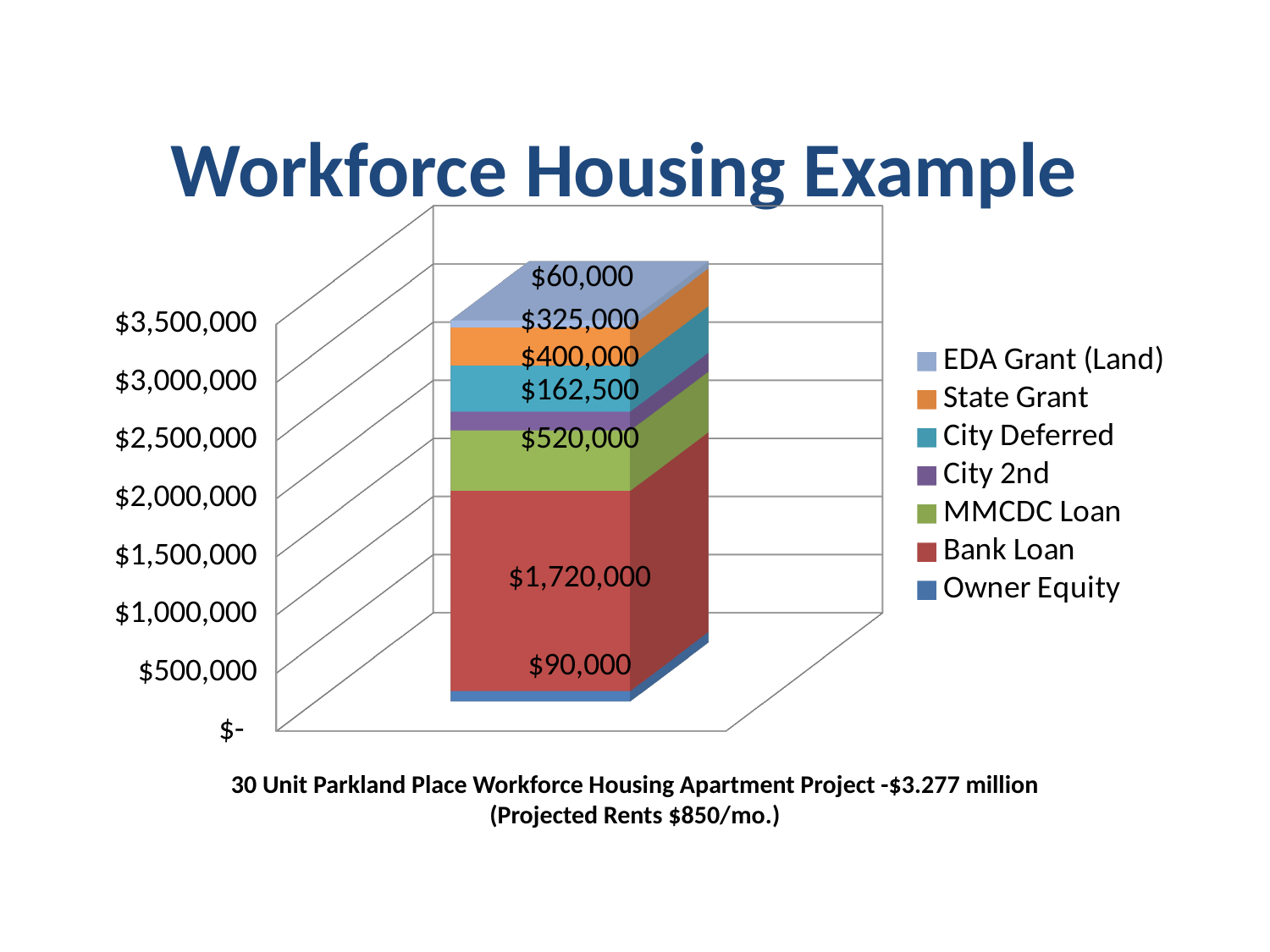
What is the difference between the City Deferred and State Grant amounts? $75,000 What is the value of the MMCDC Loan segment? $520,000 What is the value of the City 2nd segment? $162,500 What is the value of the EDA Grant (Land) segment? $60,000 What is the title of the slide? Workforce Housing Example How many series does the legend list? 7 Which is larger, the MMCDC Loan or the City Deferred amount? MMCDC Loan Which funding source contributes the largest amount? Bank Loan What is the value of the Bank Loan segment? $1,720,000 What type of chart is shown on the slide? Bar chart (stacked) What is the total of all segments in the stacked bar? $3,277,500 Which funding source contributes the smallest amount? EDA Grant (Land)